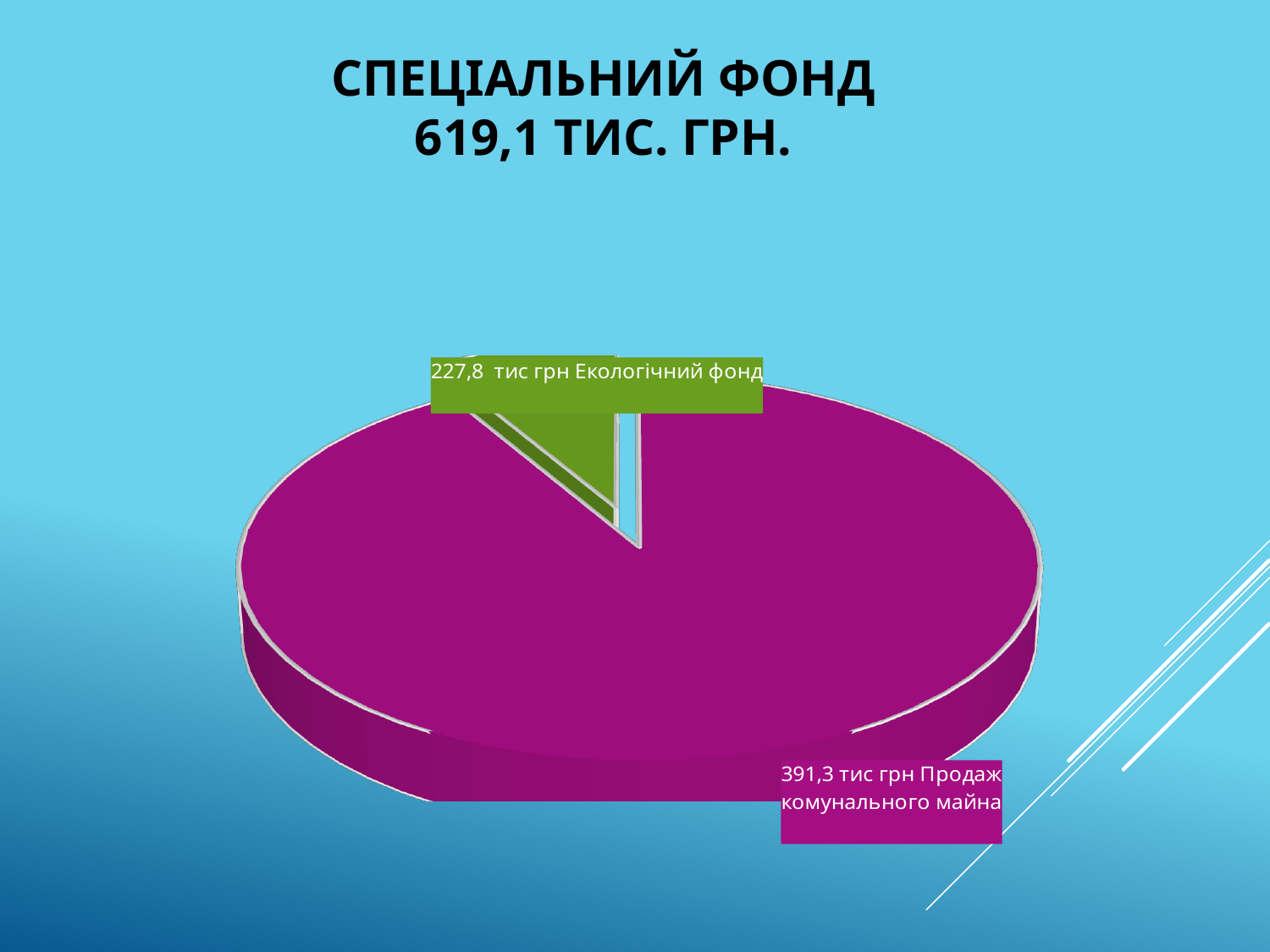
What kind of chart is shown on the slide? pie chart Which slice of the pie chart is the largest? Продаж комунального майна What is the value for Екологічний фонд? 227,8 тис грн What colour is the Екологічний фонд slice? green Which is larger, Екологічний фонд or Продаж комунального майна? Продаж комунального майна What total amount for the special fund is stated in the slide title? 619,1 тис. грн. What is the value for Продаж комунального майна? 391,3 тис грн What is the difference between Продаж комунального майна and Екологічний фонд, in тис грн? 163,5 Which slice of the pie chart is the smallest? Екологічний фонд How many slices does the pie chart have? 2